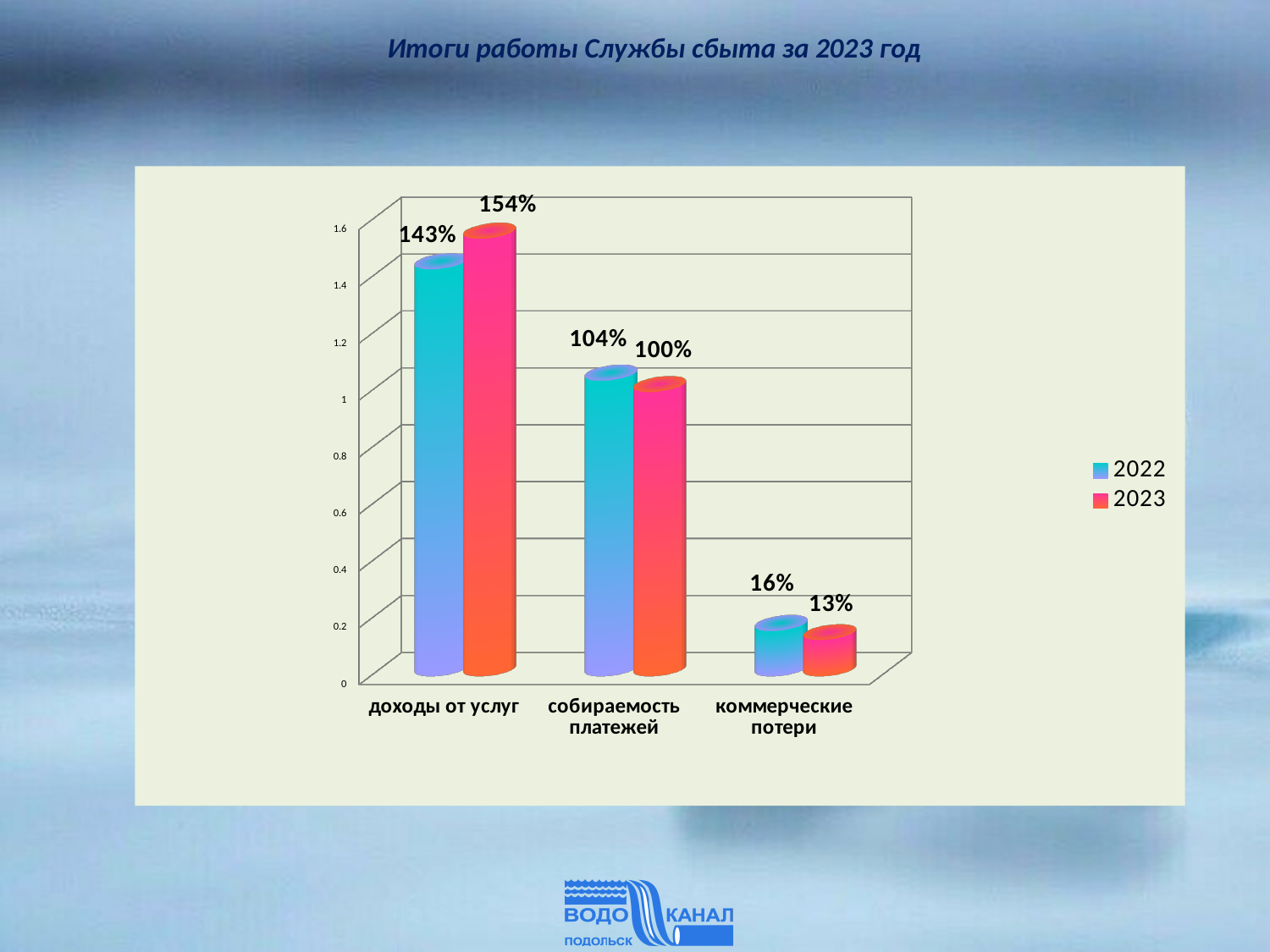
How many categories are shown on the x axis? 3 How many series does the legend list? 2 What is the value for 2023 in the category "доходы от услуг"? 154% What is the value for 2023 in the category "коммерческие потери"? 13% What is the title of the slide? Итоги работы Службы сбыта за 2023 год What kind of chart is shown on the slide? bar chart Which category has the lowest value for the 2023 series? коммерческие потери What is the difference between the 2023 and 2022 values for "доходы от услуг"? 11% Which category has the highest value for the 2022 series? доходы от услуг What is the difference between the 2022 and 2023 values for "коммерческие потери"? 3% What is the value for 2022 in the category "собираемость платежей"? 104% Which is larger for "собираемость платежей": the 2022 value or the 2023 value? 2022